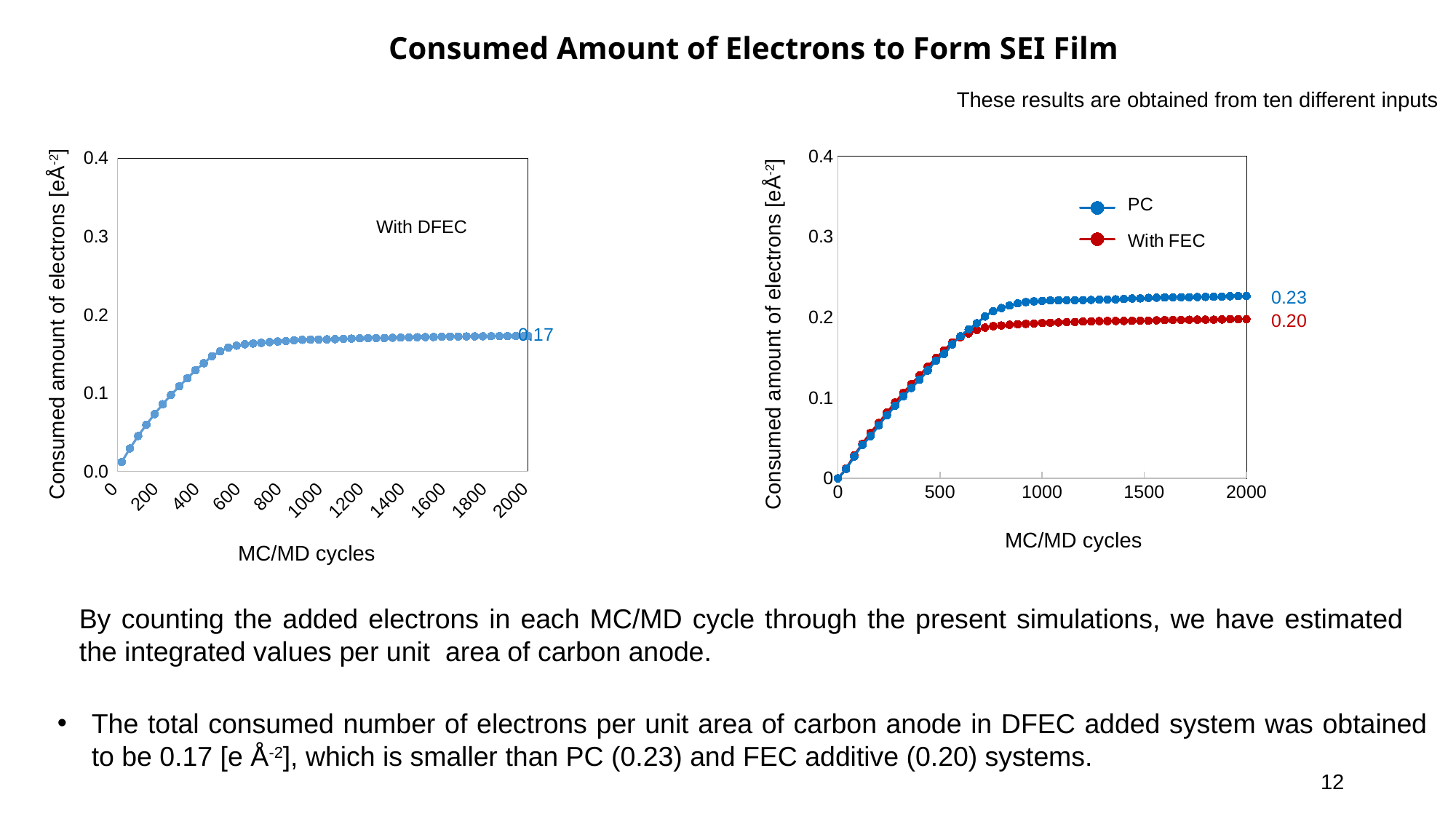
On the left chart (With DFEC), what is the labelled final value of consumed electrons at 2000 MC/MD cycles? 0.17 On the left chart, do the values rise or fall as MC/MD cycles increase? Rise On the right chart, which series reaches the higher final value, PC or With FEC? PC What kind of chart is the left chart (With DFEC)? Line chart On the right chart, what is the difference between the final values of PC and With FEC? 0.03 On the right chart, what is the labelled final value for the With FEC series? 0.20 How many series does the legend on the right chart list? 2 On the right chart, what is the labelled final value for the PC series? 0.23 On the left chart, is the value at 400 MC/MD cycles greater or less than 0.2? less On the right chart, is the final value of the PC series greater or less than 0.3? less What is the x-axis label of the right chart? MC/MD cycles On the right chart, what colour is the With FEC series plotted in? Red